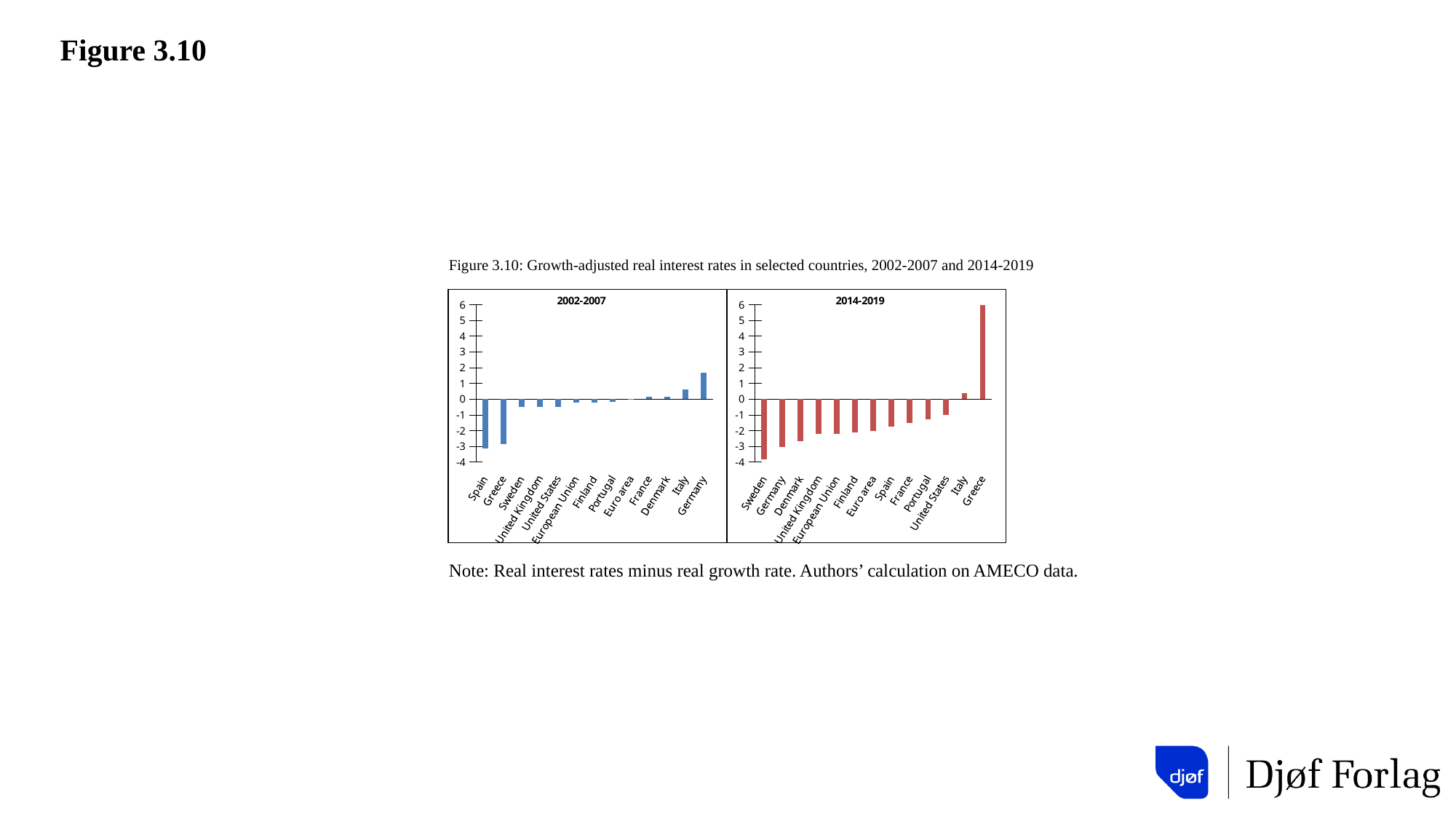
How many countries or regions are plotted in the 2014-2019 chart? 13 In the 2002-2007 chart, which country has the highest growth-adjusted real interest rate? Germany In the 2014-2019 chart, is the value for Germany greater or less than -2? less In the 2014-2019 chart, which is larger, the value for Italy or the value for United States? Italy In the 2002-2007 chart, is the value for Germany greater or less than 1? greater In the 2002-2007 chart, do the values rise or fall moving from left to right along the x axis? rise What kind of chart is shown in the 2002-2007 panel? bar chart What is the title of the right-hand chart panel? 2014-2019 In the 2002-2007 chart, is the value for Spain greater or less than -2? less In the 2014-2019 chart, which country has the highest growth-adjusted real interest rate? Greece In the 2014-2019 chart, which country has the lowest growth-adjusted real interest rate? Sweden